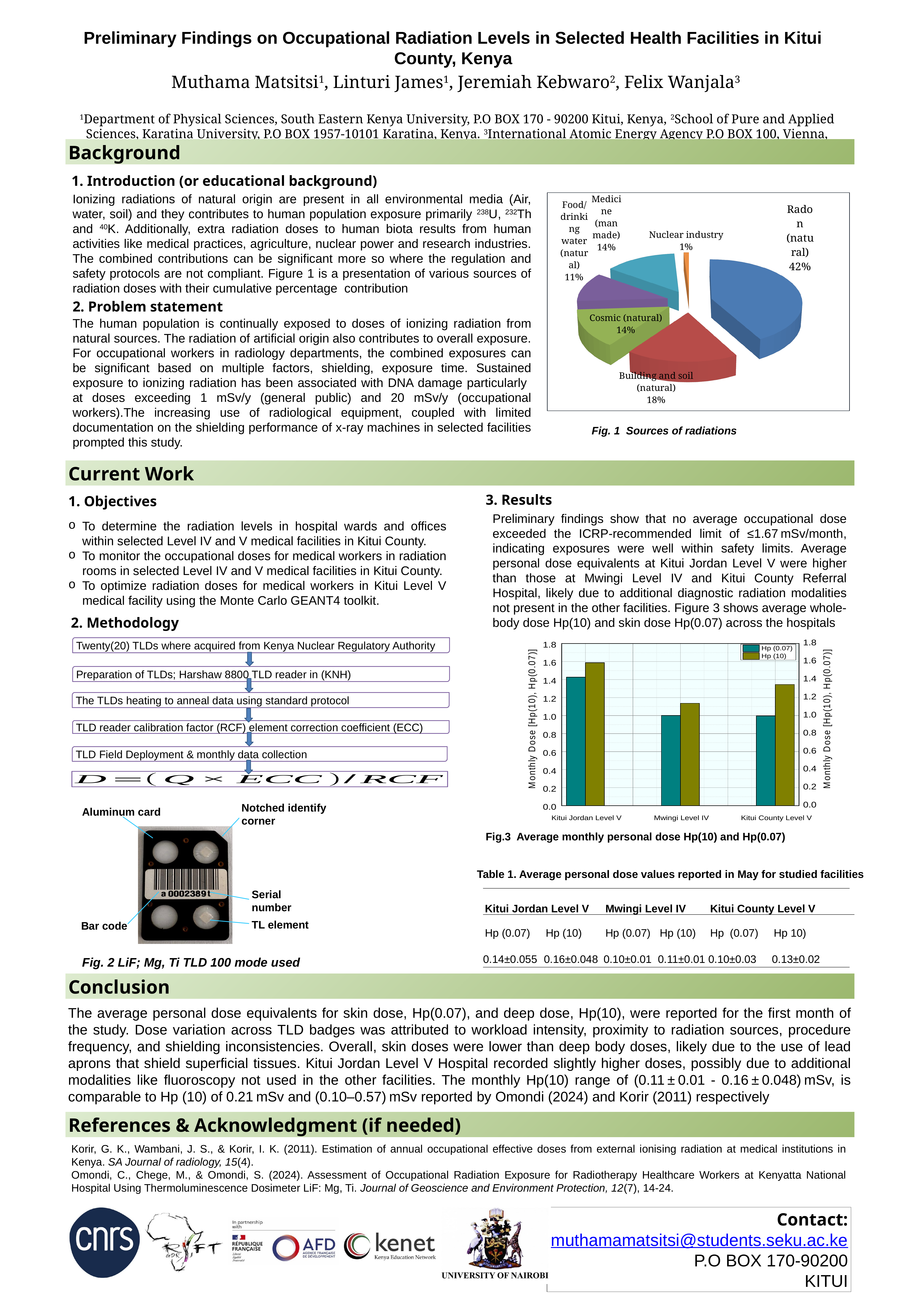
In the pie chart 'Fig. 1 Sources of radiations', which source has the smallest share? Nuclear industry In the pie chart 'Fig. 1 Sources of radiations', how many slices are shown? 6 In the bar chart Fig. 3, how many hospitals are shown on the x axis? 3 In the bar chart Fig. 3, is the Hp (0.07) value for Kitui Jordan Level V greater or less than 1.2? greater In the pie chart 'Fig. 1 Sources of radiations', which is larger: Cosmic (natural) or Food/drinking water (natural)? Cosmic (natural) In the pie chart 'Fig. 1 Sources of radiations', which source has the largest share? Radon (natural) In the bar chart Fig. 3, which hospital has the highest Hp (10) value? Kitui Jordan Level V What type of chart is Fig. 3 'Average monthly personal dose Hp(10) and Hp(0.07)'? Bar chart In the pie chart 'Fig. 1 Sources of radiations', what percentage is attributed to Radon (natural)? 42% In the pie chart 'Fig. 1 Sources of radiations', what percentage is attributed to Building and soil (natural)? 18% In the pie chart 'Fig. 1 Sources of radiations', what is the difference between the Radon (natural) share and the Building and soil (natural) share? 24% In the bar chart Fig. 3, how many series does the legend list? 2